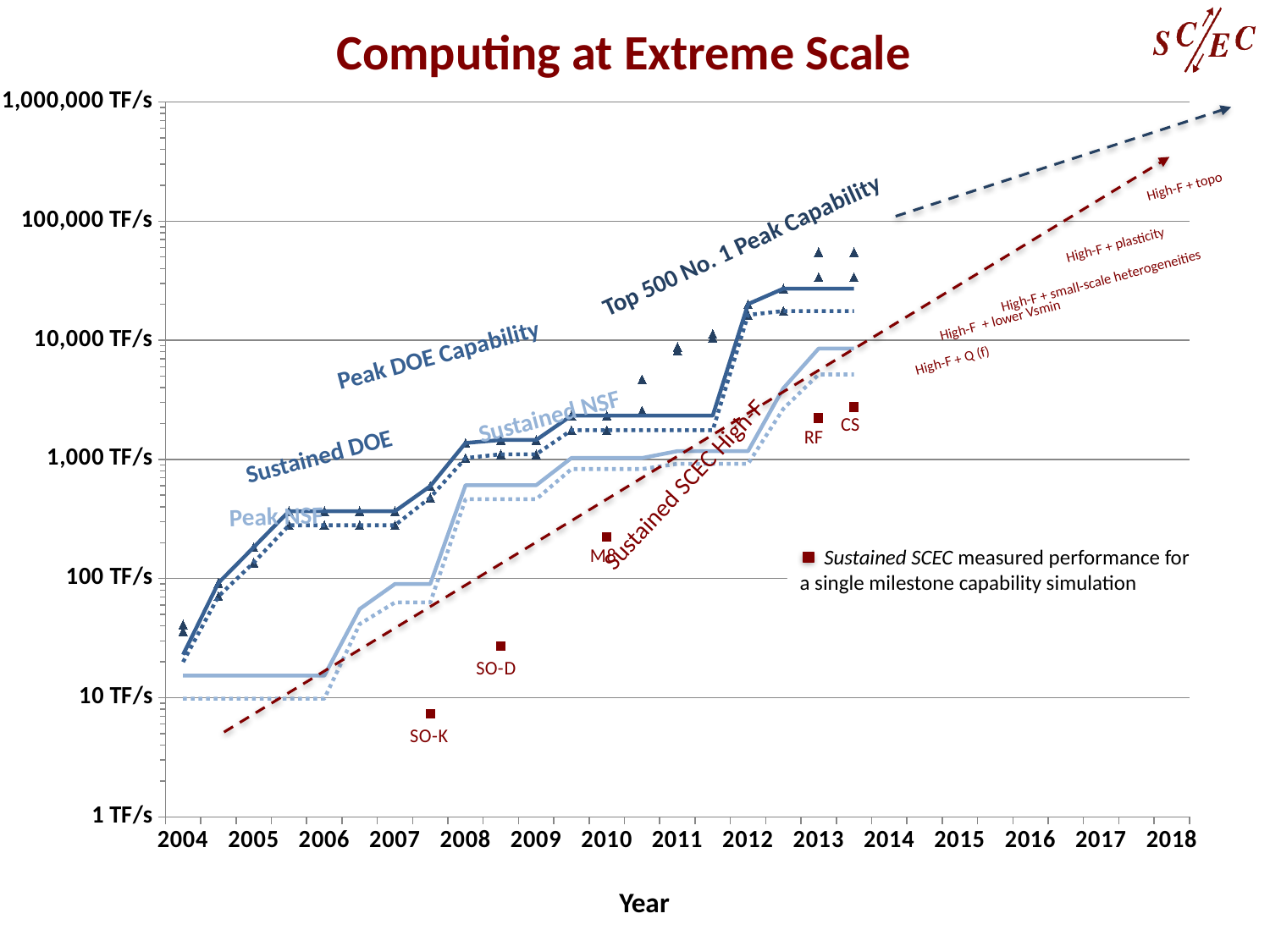
What kind of chart is shown on the slide? line chart Which has the higher measured performance, M8 or SO-D? M8 How many labelled Sustained SCEC milestone simulation points (red squares) are plotted? 5 Is the Top 500 No. 1 Peak Capability in 2013 greater or less than 100,000 TF/s? less What is the title of the chart? Computing at Extreme Scale Which labelled Sustained SCEC milestone point has the lowest measured performance? SO-K Is the measured performance for RF greater or less than 1,000 TF/s? greater Is the measured performance for SO-D greater or less than 10 TF/s? greater Do the computing capability lines rise or fall as the year increases? rise What is the label of the x axis? Year